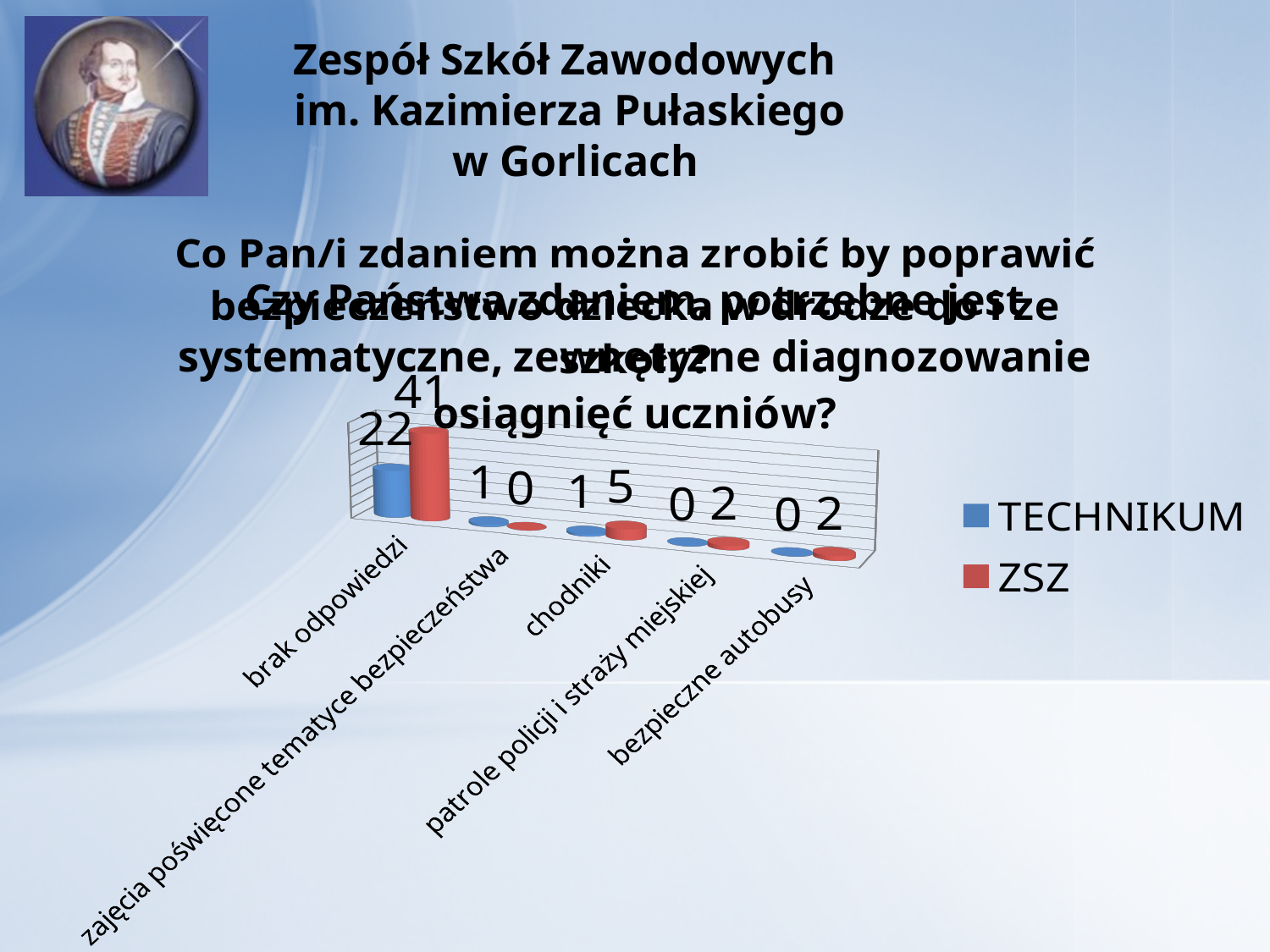
What is the TECHNIKUM value for 'zajęcia poświęcone tematyce bezpieczeństwa'? 1 How many categories are shown on the x axis of the chart? 5 What is the ZSZ value for 'brak odpowiedzi'? 41 What is the difference between the ZSZ and TECHNIKUM values for 'brak odpowiedzi'? 19 How many series does the chart legend list? 2 What is the ZSZ value for 'bezpieczne autobusy'? 2 Which colour represents the ZSZ series in the chart? red Which category has the highest ZSZ value? brak odpowiedzi What is the TECHNIKUM value for 'brak odpowiedzi'? 22 For 'chodniki', which series has the larger value, TECHNIKUM or ZSZ? ZSZ What is the ZSZ value for 'chodniki'? 5 What kind of chart is shown on the slide? bar chart